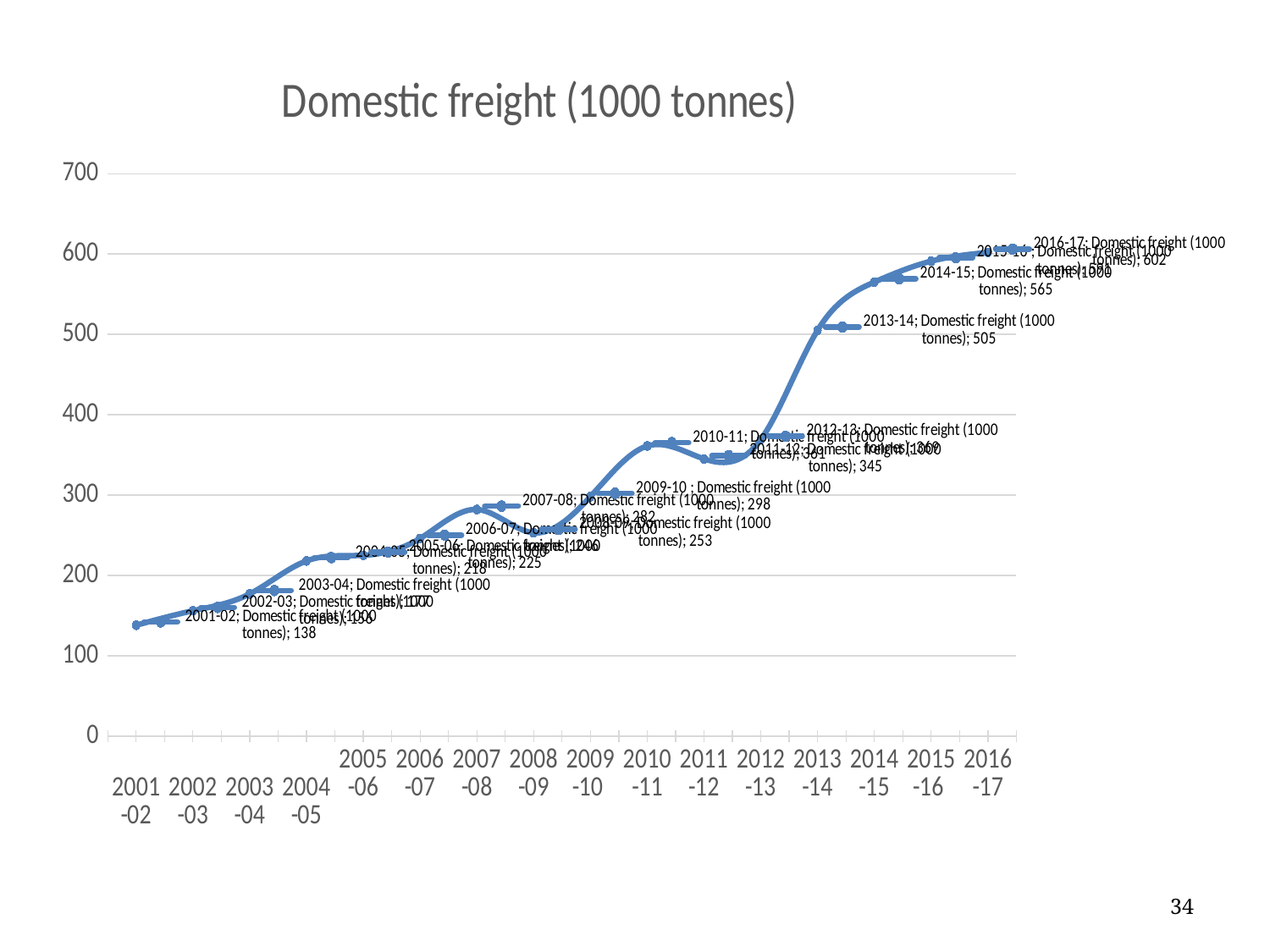
Which year has the lowest domestic freight value? 2001-02 What is the domestic freight value for 2001-02? 138 What is the domestic freight value for 2016-17? 602 What is the domestic freight value for 2013-14? 505 By how much did domestic freight increase from 2013-14 to 2014-15? 60 What is the title of the chart? Domestic freight (1000 tonnes) What is the domestic freight value for 2014-15? 565 What kind of chart is shown on the slide? line chart Is the domestic freight value for 2010-11 greater or less than 300? greater How many years are plotted on the x axis? 16 Which year has the highest domestic freight value? 2016-17 What is the domestic freight value for 2008-09? 253